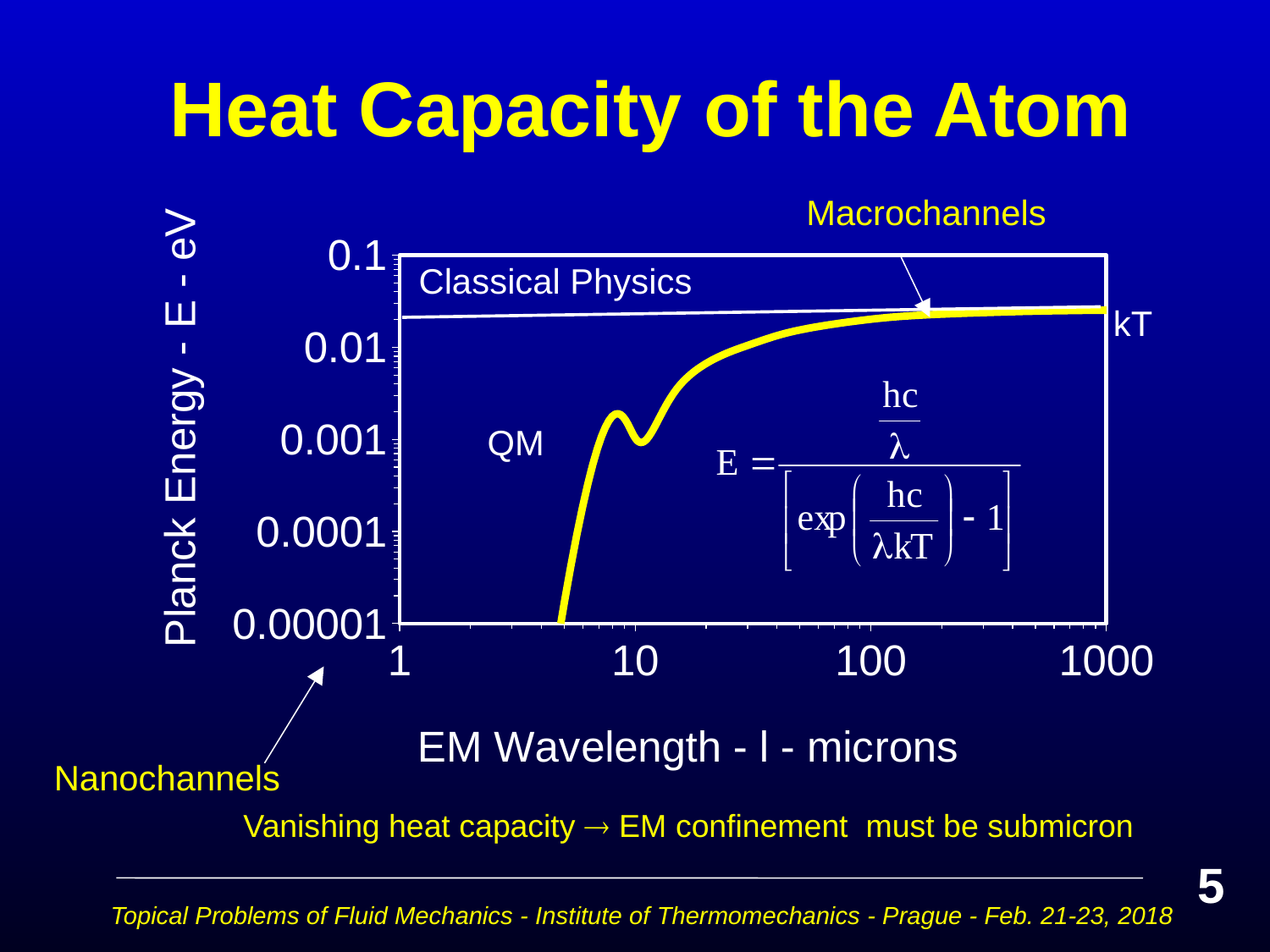
Is the Planck energy of the yellow curve at a wavelength of 1000 microns greater or less than 0.1 eV? less Is the Planck energy of the yellow curve at a wavelength of 100 microns greater or less than 0.01 eV? greater What is the title of the slide containing the chart? Heat Capacity of the Atom What label is given to the horizontal white line at the top of the chart? kT How many labelled tick values are shown on the x axis? 4 What kind of chart is shown on the slide? line chart Is the Planck energy of the yellow curve at a wavelength of 10 microns greater or less than 0.01 eV? less Which wavelength has the larger Planck energy on the yellow curve, 10 microns or 100 microns? 100 microns What is the highest value labelled on the x axis? 1000 What is the lowest value labelled on the y axis? 0.00001 How many labelled tick values are shown on the y axis? 5 Does the yellow curve rise or fall as the EM wavelength increases from 1 to 1000 microns? rise